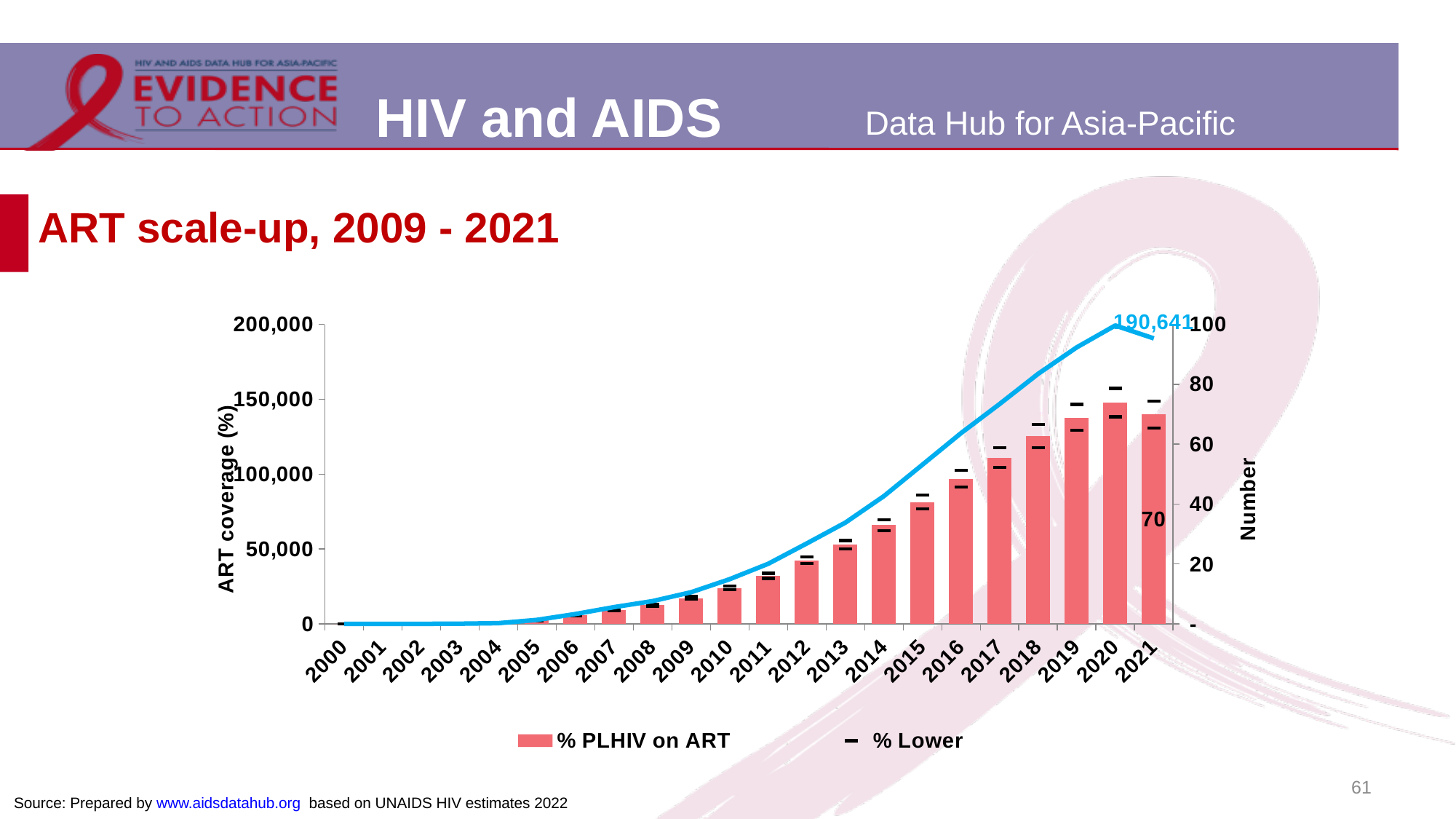
Which bar is taller, 2018 or 2014? 2018 How many years are shown on the x axis? 22 What value is labelled on the bar for 2021? 70 Which year has the tallest bar? 2020 Do the bars rise or fall from 2005 to 2020? Rise How many series does the legend list? 2 Is the line value for 2014 greater or less than 100,000 on the left-hand axis? less What is the title of the chart? ART scale-up, 2009 - 2021 Is the bar for 2013 greater or less than 40 on the right-hand axis? less What kind of chart is this? Combined bar and line chart Is the bar for 2016 greater or less than 40 on the right-hand axis? greater